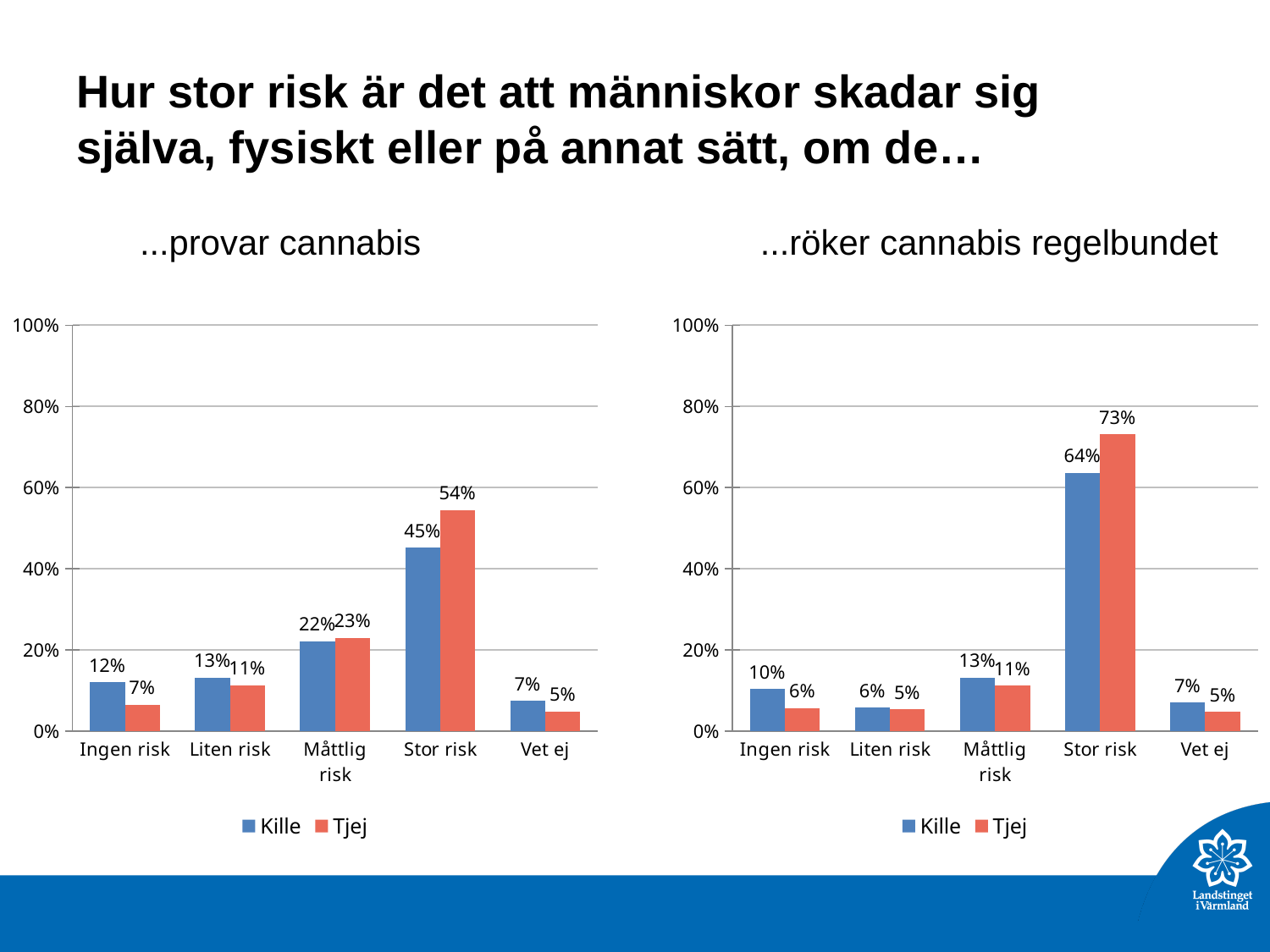
In the '...röker cannabis regelbundet' chart, which category has the highest value for Kille? Stor risk In the '...röker cannabis regelbundet' chart, what is the difference between the Tjej and Kille values for Stor risk? 9% In the '...provar cannabis' chart, what is the value for Kille in the Stor risk category? 45% How many series does the legend of the '...röker cannabis regelbundet' chart list? 2 How many categories are shown on the x axis of the '...provar cannabis' chart? 5 In the '...röker cannabis regelbundet' chart, what is the value for Tjej in the Stor risk category? 73% In the '...provar cannabis' chart, which category has the lowest value for Tjej? Vet ej In the '...provar cannabis' chart, what is the value for Tjej in the Ingen risk category? 7% What kind of chart is the '...provar cannabis' chart? Bar chart In the '...röker cannabis regelbundet' chart, is the value for Kille in Stor risk greater or less than 60%? greater In the '...provar cannabis' chart, which colour represents Tjej? Red/orange In the '...provar cannabis' chart, which is larger for Liten risk: Kille or Tjej? Kille